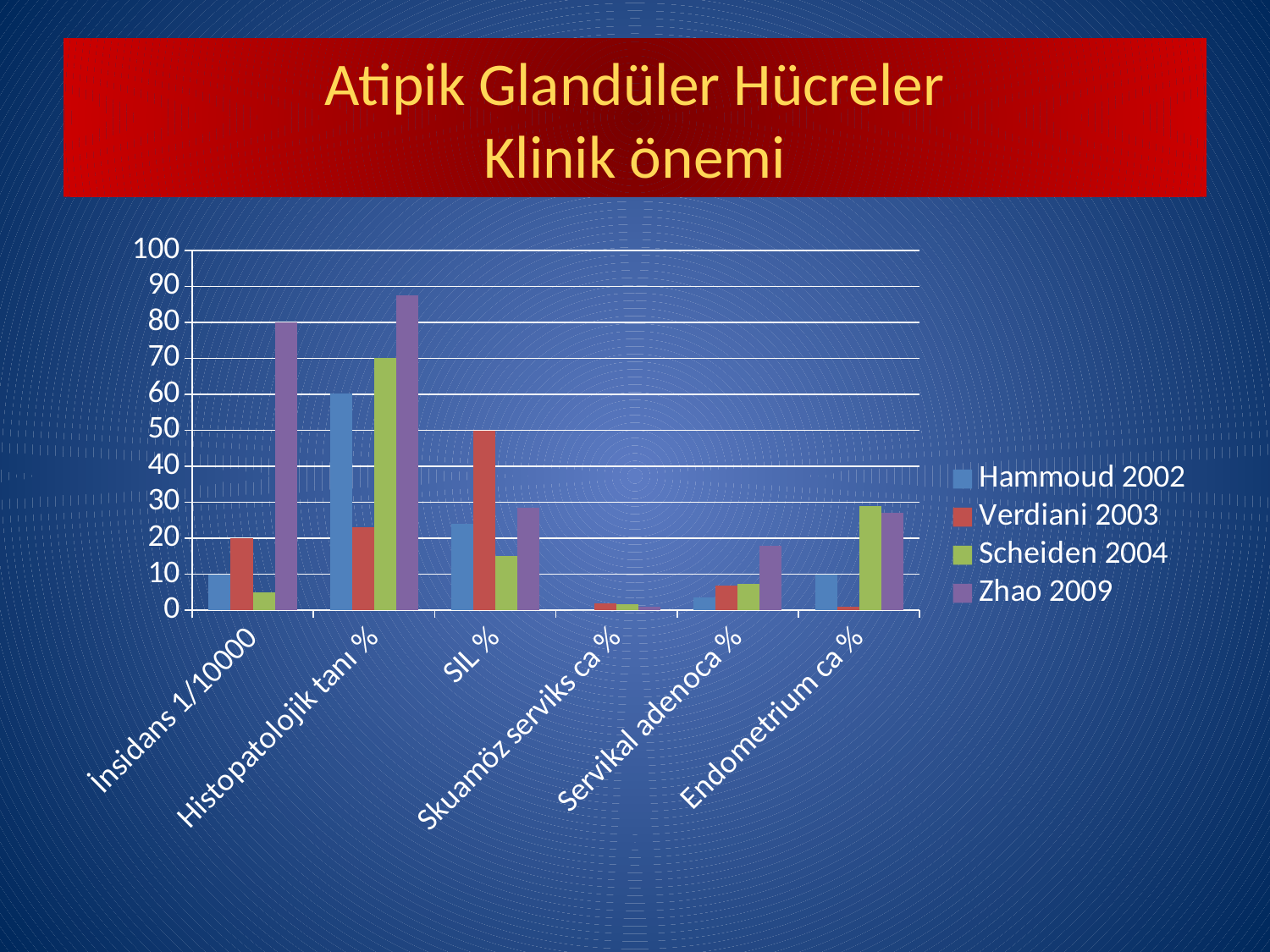
Which series has the highest value for Histopatolojik tanı %? Zhao 2009 Which series has the highest value for SIL %? Verdiani 2003 Which series has the lowest value for Histopatolojik tanı %? Verdiani 2003 Is the value for Zhao 2009 in Histopatolojik tanı % greater or less than 80? greater Is the value for Scheiden 2004 in İnsidans 1/10000 greater or less than 10? less What kind of chart is shown on the slide? bar chart How many categories are shown on the x axis? 6 How many series does the legend list? 4 Which series is shown in green in the legend? Scheiden 2004 Which series has the highest value for İnsidans 1/10000? Zhao 2009 Which is larger for Endometrium ca %: Scheiden 2004 or Hammoud 2002? Scheiden 2004 Is the value for Zhao 2009 in Servikal adenoca % greater or less than 10? greater